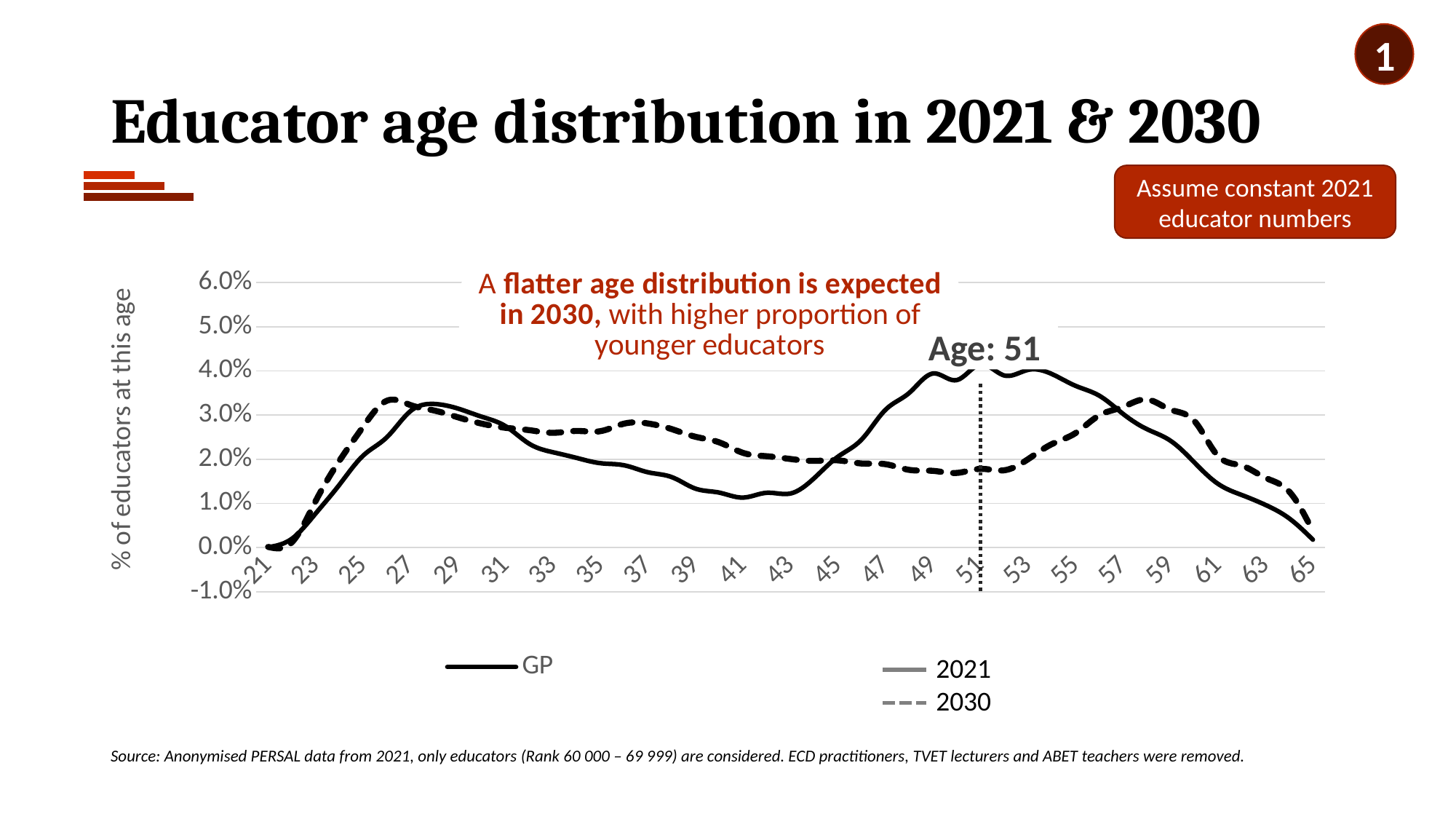
Is the 2030 (dashed) value at age 41 greater or less than 1.0%? greater At age 51, which series has the higher value, 2021 or 2030? 2021 At age 59, which series has the higher value, 2021 or 2030? 2030 At age 41, which series has the higher value, 2021 or 2030? 2030 Is the 2021 (solid) value at age 65 greater or less than 1.0%? less Which line style represents 2030 in the legend? dashed What is the label of the vertical axis? % of educators at this age What kind of chart is shown on the slide? line chart Is the 2021 (solid) value at age 51 greater or less than 3.0%? greater Does the 2021 (solid) line rise or fall between age 53 and age 65? fall How many lines are plotted on the chart? 2